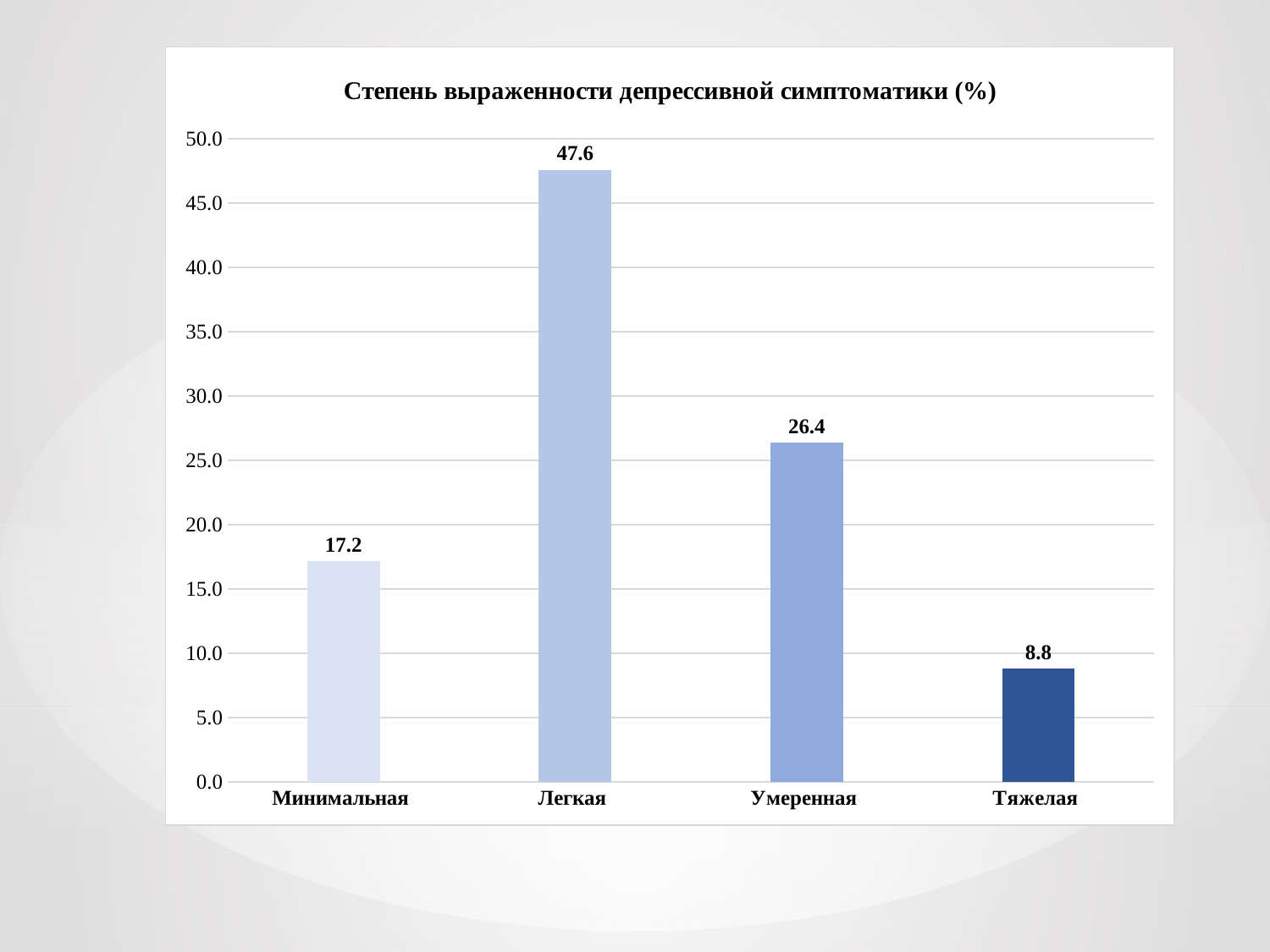
What is the value for Легкая? 47.6 How many categories are shown on the x axis? 4 Is the value for Умеренная greater or less than 25.0? greater Which category has the highest value? Легкая What is the value for Умеренная? 26.4 What is the difference between the values for Легкая and Умеренная? 21.2 What is the value for Минимальная? 17.2 What kind of chart is shown on the slide? bar chart What is the difference between the values for Минимальная and Тяжелая? 8.4 Which category has the lowest value? Тяжелая Which is larger, the value for Минимальная or the value for Умеренная? Умеренная What is the value for Тяжелая? 8.8